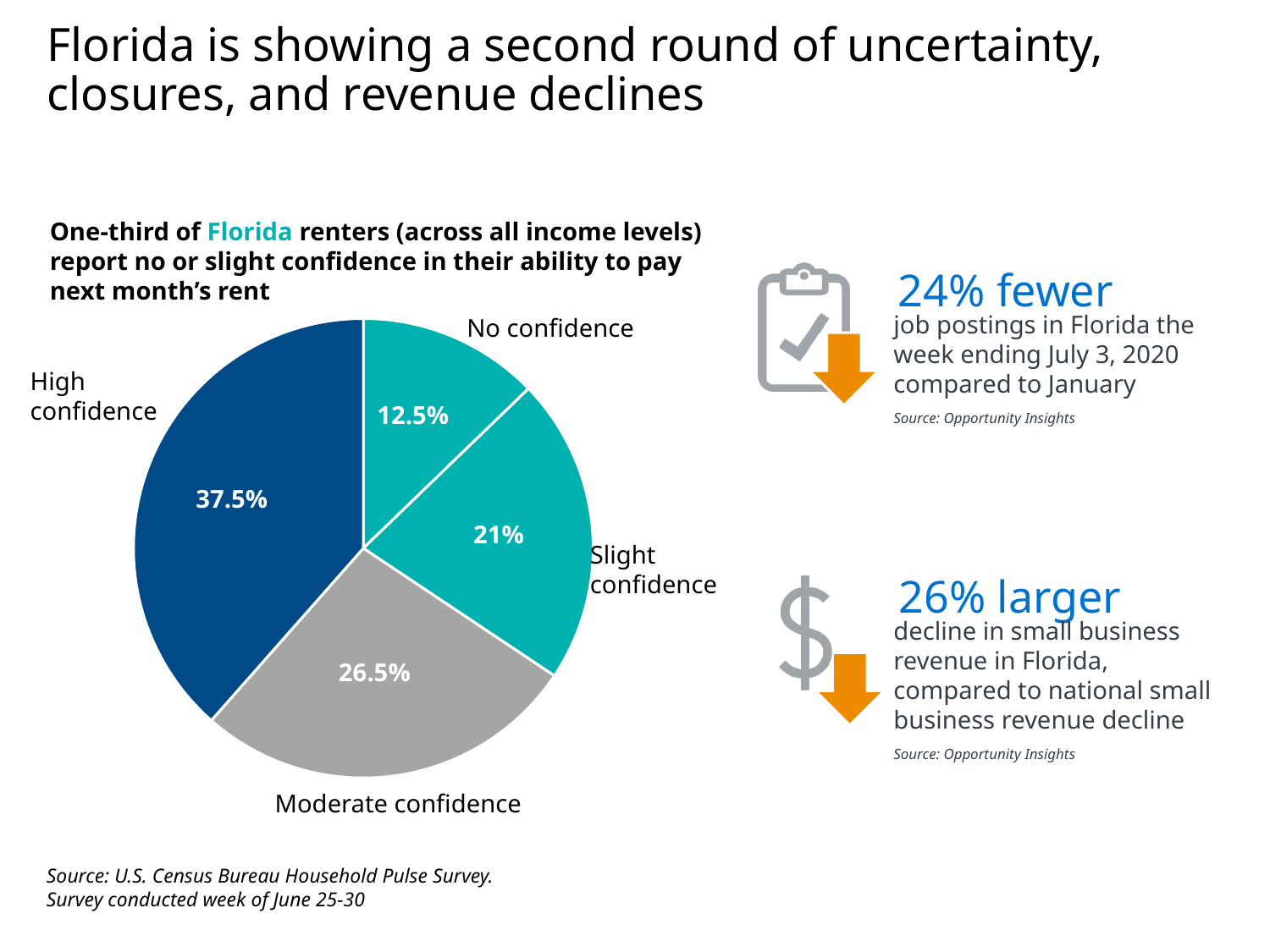
Which is larger, the slight confidence slice or the moderate confidence slice? Moderate confidence What is the combined share of the no confidence and slight confidence slices? 33.5% What kind of chart is shown on the slide? Pie chart Which confidence level has the largest share of the pie? High confidence What percentage of Florida renters report moderate confidence? 26.5% What colour is the high confidence slice of the pie chart? Dark blue What percentage of Florida renters report no confidence in their ability to pay next month's rent? 12.5% Which confidence level has the smallest share of the pie? No confidence What percentage of Florida renters report slight confidence? 21% How many slices does the pie chart have? 4 What percentage of Florida renters report high confidence in their ability to pay next month's rent? 37.5% What is the difference in percentage points between the high confidence and moderate confidence slices? 11